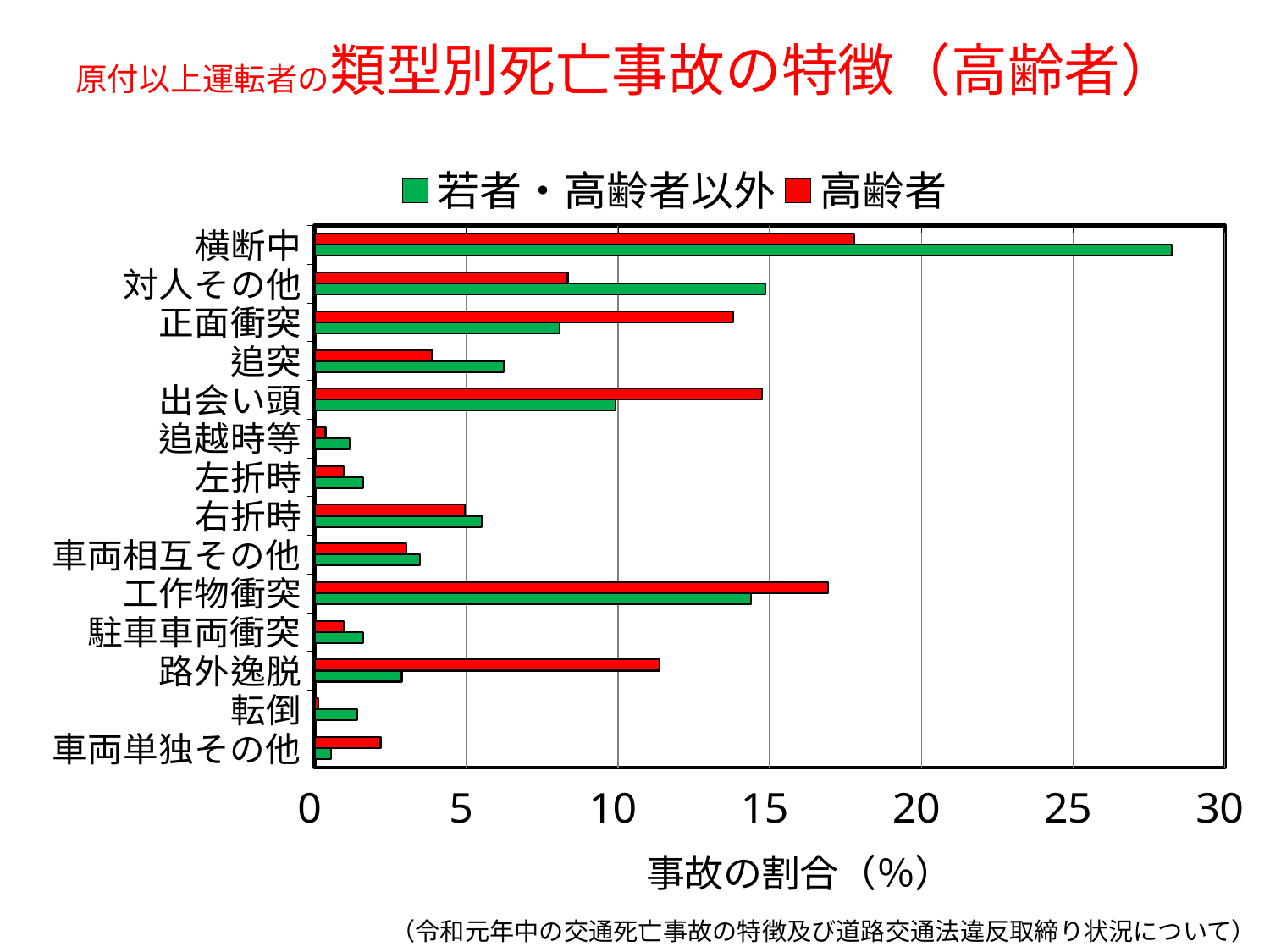
What kind of chart is shown on the slide? bar chart Is the value for 横断中 in the 若者・高齢者以外 series greater or less than 25? greater Which category has the lowest value for 高齢者? 転倒 For 横断中, which series has the larger value, 若者・高齢者以外 or 高齢者? 若者・高齢者以外 Is the value for 工作物衝突 in the 高齢者 series greater or less than 15? greater Is the value for 路外逸脱 in the 高齢者 series greater or less than 10? greater Which category has the highest value for 若者・高齢者以外? 横断中 For 正面衝突, which series has the larger value, 若者・高齢者以外 or 高齢者? 高齢者 How many accident categories are plotted on the chart? 14 How many series does the legend list? 2 What is the label of the horizontal axis? 事故の割合（%）